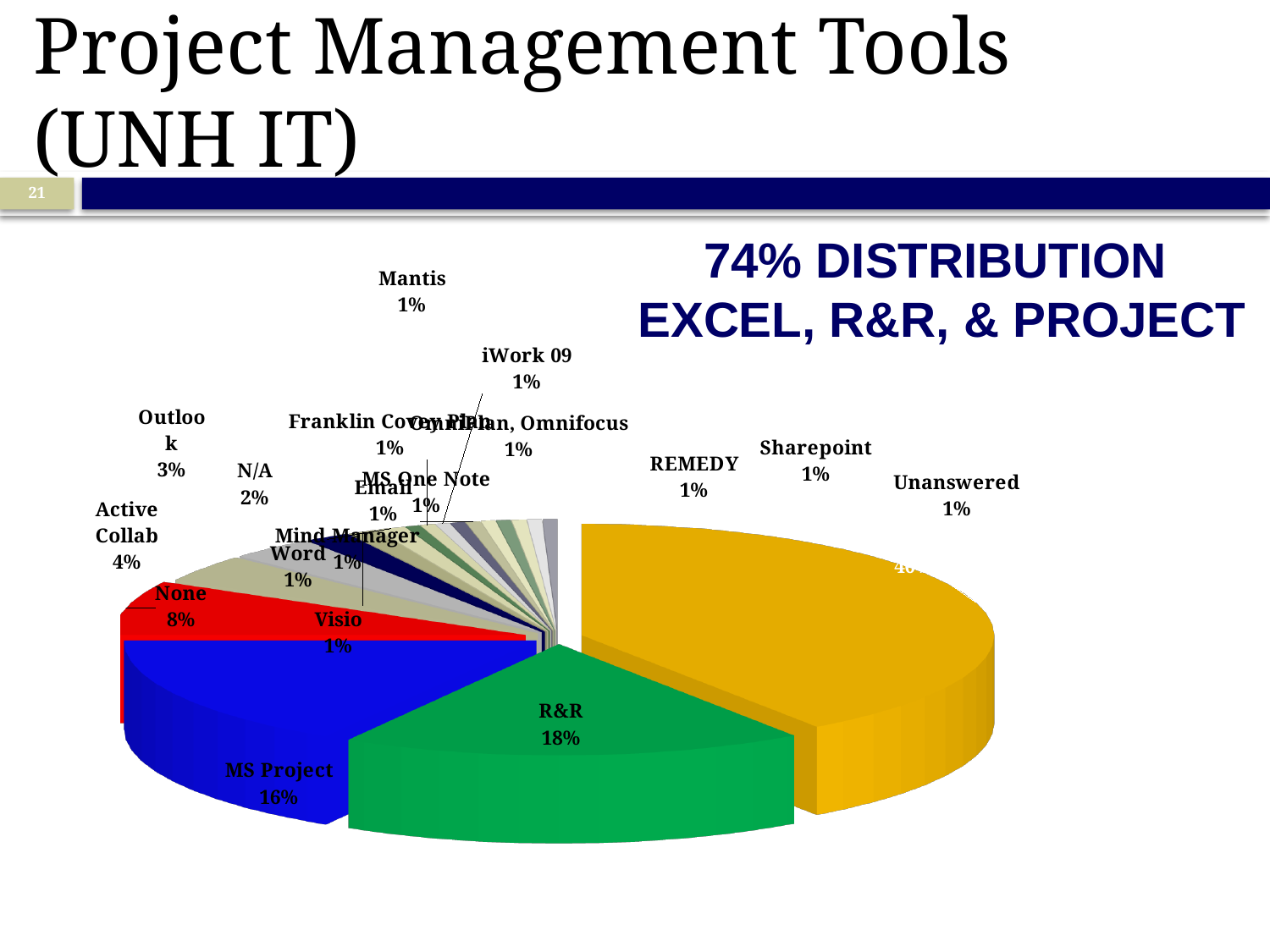
What percentage of the pie is N/A? 2% What percentage of the pie is None? 8% What percentage of the pie is Sharepoint? 1% What percentage of the pie is MS Project? 16% What percentage of the pie is R&R? 18% Which slice is larger, R&R or MS Project? R&R What percentage of the pie is Active Collab? 4% What is the difference in percentage points between R&R and MS Project? 2 percentage points Which slice is larger, None or Active Collab? None What percentage of the pie is Outlook? 3% What type of chart is shown on the slide? Pie chart What does the text annotation to the right of the chart say? 74% DISTRIBUTION EXCEL, R&R, & PROJECT